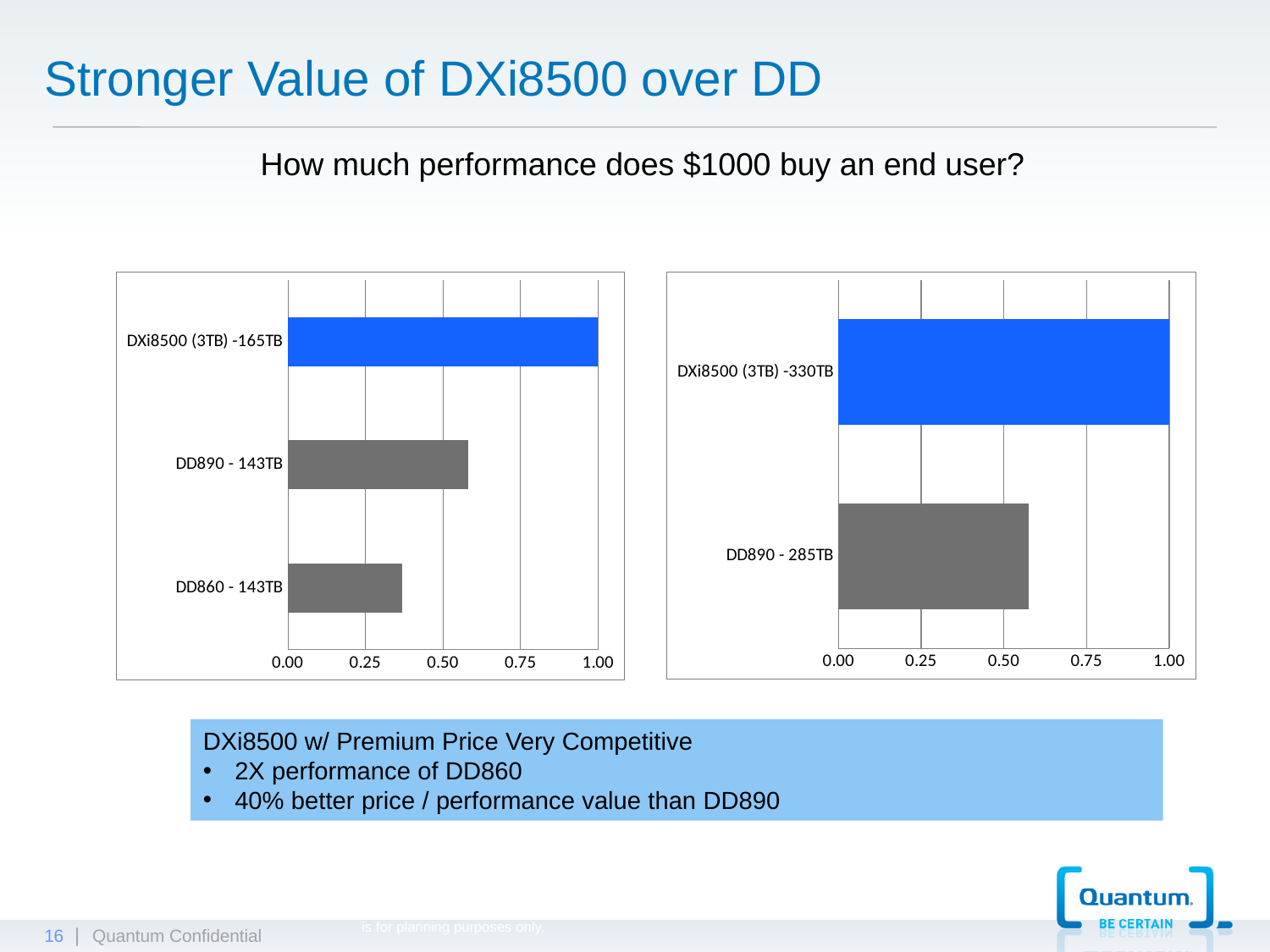
On the right chart, is the value for DD890 - 285TB greater or less than 0.75? less On the right chart, which category has the longest bar? DXi8500 (3TB) -330TB How many categories are shown on the right chart? 2 On the left chart, which category has the shortest bar? DD860 - 143TB How many categories are shown on the left chart? 3 On the left chart, is the value for DD890 - 143TB greater or less than 0.50? greater On the left chart, is the value for DD860 - 143TB greater or less than 0.50? less On the left chart, which category has the longest bar? DXi8500 (3TB) -165TB What type of chart is the right chart? Bar chart On the left chart, which is larger, the value for DD890 - 143TB or DD860 - 143TB? DD890 - 143TB On the right chart, what is the value for DXi8500 (3TB) -330TB? 1.00 On the left chart, what is the value for DXi8500 (3TB) -165TB? 1.00